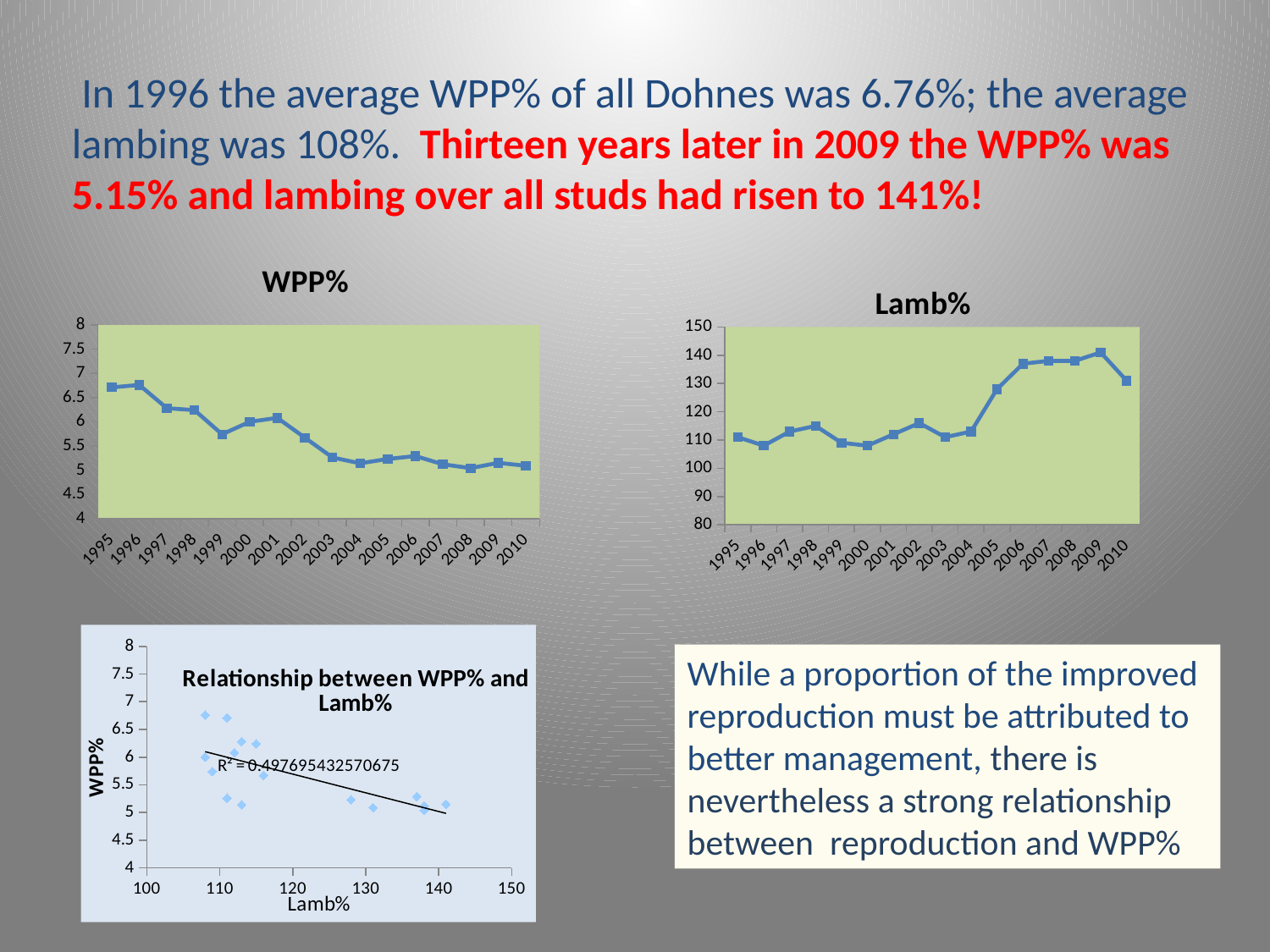
What type of chart is the bottom-left chart titled 'Relationship between WPP% and Lamb%'? scatter chart In the WPP% chart, do the values generally rise or fall from 1995 to 2010? fall What R² value is printed on the 'Relationship between WPP% and Lamb%' scatter chart? R² = 0.497695432570675 In the Lamb% chart, is the value for 2006 greater or less than 130? greater In the Lamb% chart, which is larger, the value for 2002 or the value for 2006? 2006 How many years are plotted on the x axis of the WPP% chart? 16 In the WPP% chart, is the value for 1995 greater or less than 6.5? greater In the WPP% chart, is the value for 2004 greater or less than 5.5? less In the Lamb% chart, which year has the highest value? 2009 What type of chart is the WPP% chart? line chart In the Lamb% chart, do the values generally rise or fall from 1995 to 2010? rise